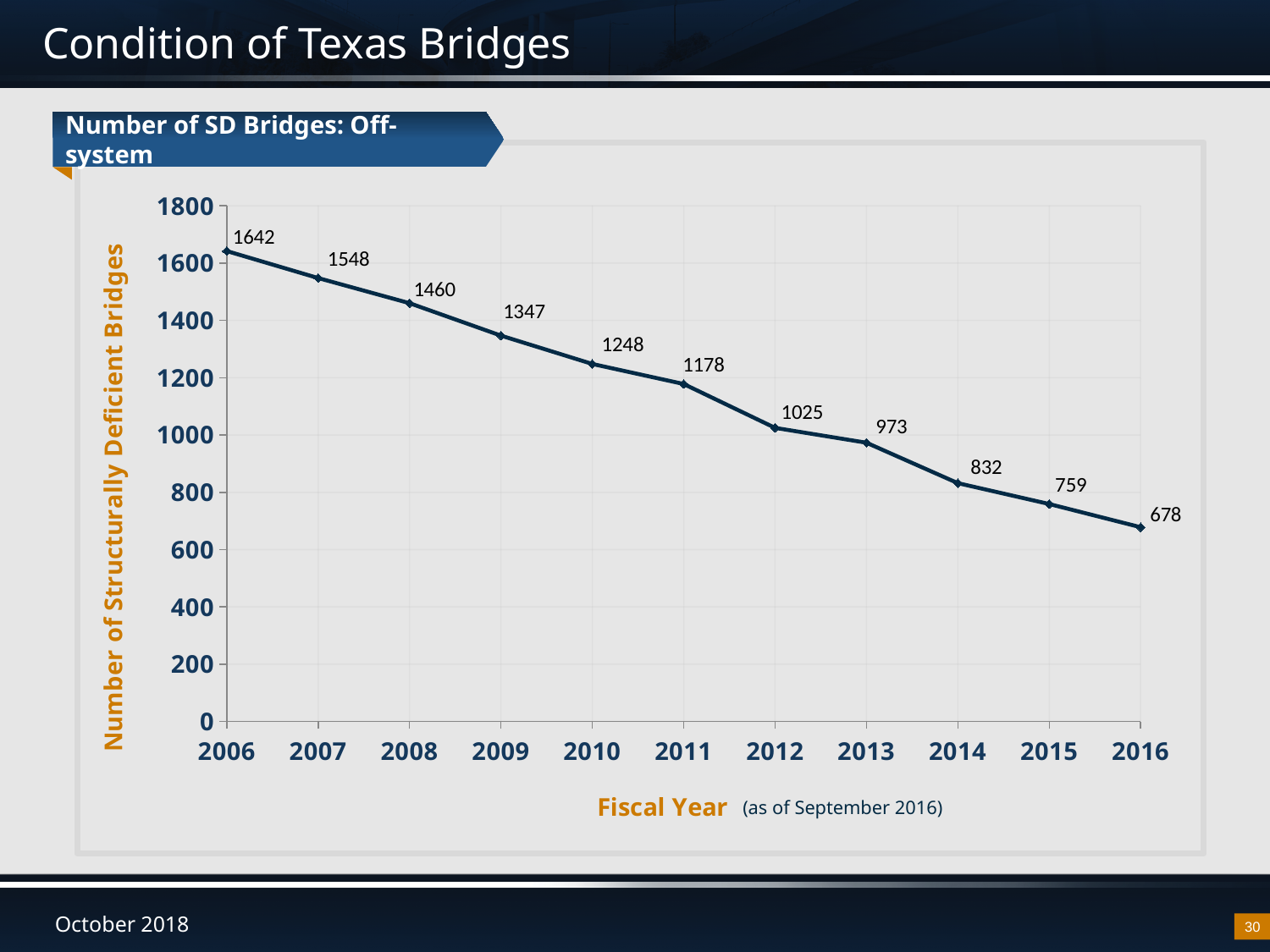
What is the number of structurally deficient off-system bridges in 2012? 1025 What is the number of structurally deficient off-system bridges in 2016? 678 What kind of chart is shown on the slide? line chart Is the value for 2014 greater or less than 1000? less Which year has a larger value, 2009 or 2013? 2009 How many fiscal years are plotted on the chart? 11 Which fiscal year has the highest number of structurally deficient bridges? 2006 Which fiscal year has the lowest number of structurally deficient bridges? 2016 What is the number of structurally deficient off-system bridges in 2006? 1642 What is the difference between the values for 2011 and 2012? 153 Do the values rise or fall from 2006 to 2016? fall By how much did the number of structurally deficient bridges decrease from 2006 to 2016? 964